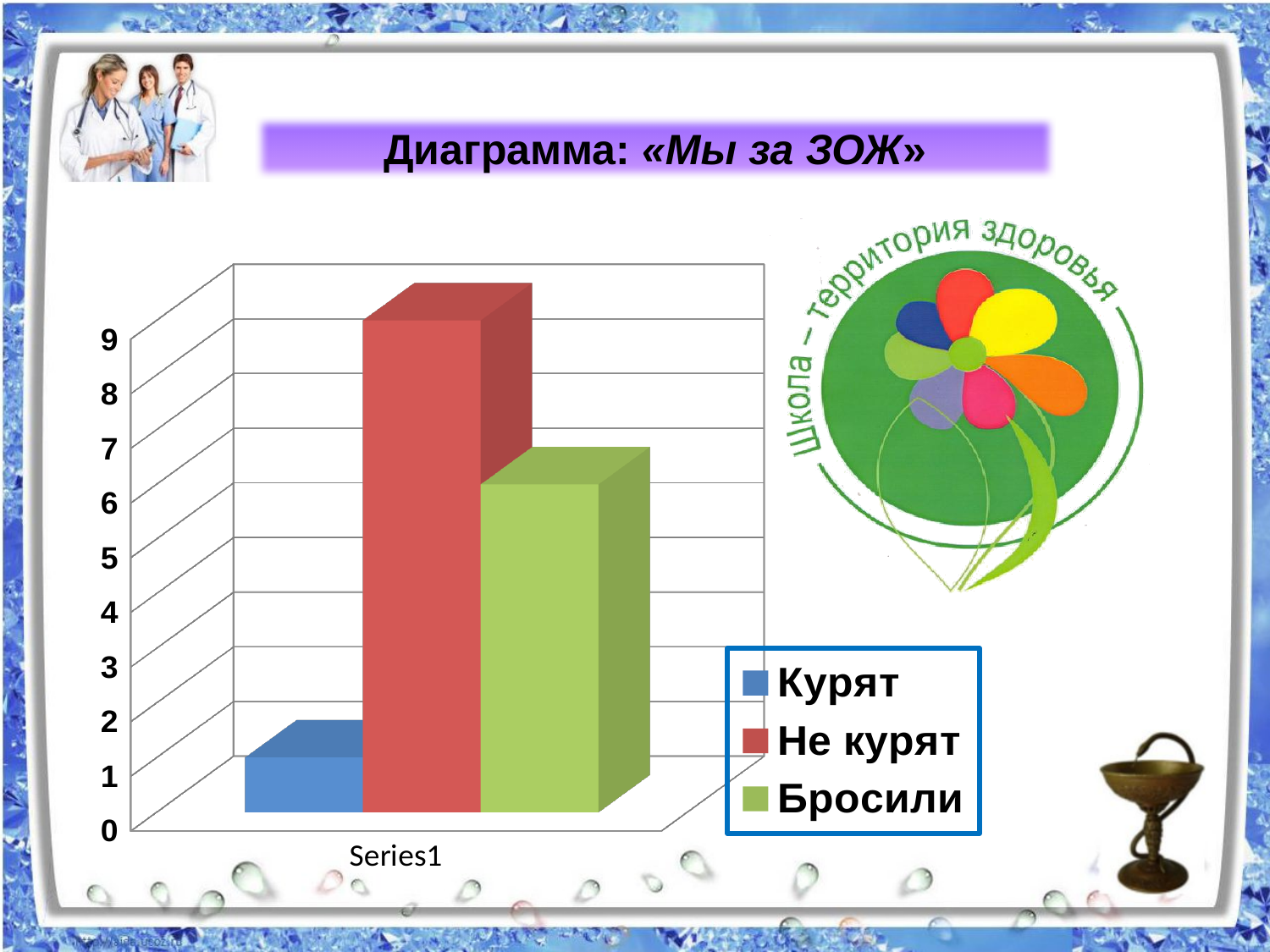
Is the value for Бросили greater or less than 7? less Which is larger, the value for Не курят or the value for Бросили? Не курят Is the value for Бросили greater or less than 5? greater What colour is the bar for Бросили? green What kind of chart is shown on the slide? bar chart Which series has the highest bar? Не курят Is the value for Курят greater or less than 2? less What is the title of the chart on the slide? Диаграмма: «Мы за ЗОЖ» How many series does the legend list? 3 Which is larger, the value for Курят or the value for Бросили? Бросили Which series has the lowest bar? Курят